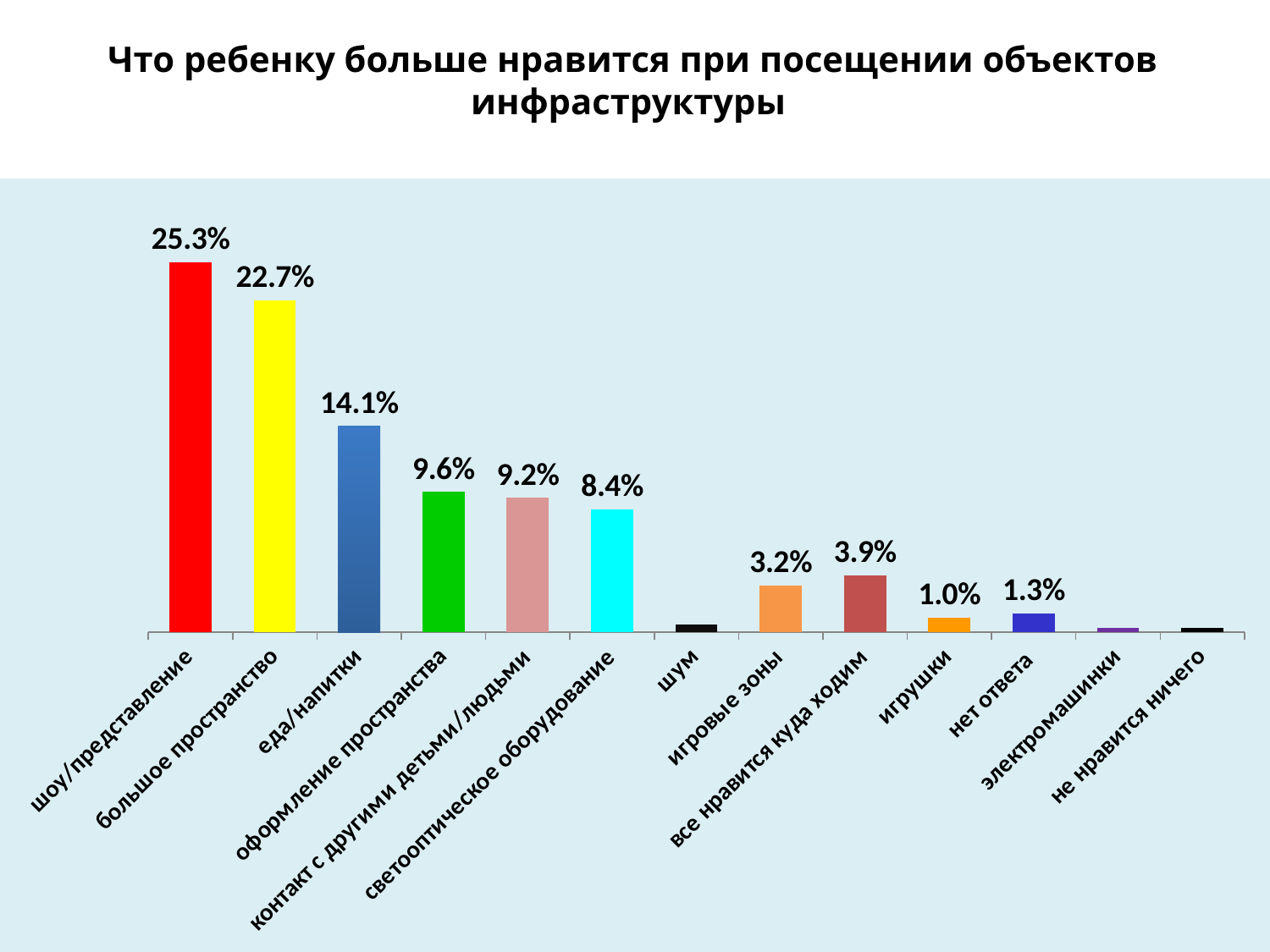
What is the value for большое пространство? 22.7% What is the value for еда/напитки? 14.1% How many categories are shown on the x axis? 13 What is the value for игрушки? 1.0% What is the value for шоу/представление? 25.3% Which is larger, the value for игровые зоны or the value for все нравится куда ходим? все нравится куда ходим What type of chart is shown on the slide? bar chart What is the value for светооптическое оборудование? 8.4% What is the title of the chart? Что ребенку больше нравится при посещении объектов инфраструктуры What is the difference between the values for шоу/представление and большое пространство? 2.6% What is the difference between the values for оформление пространства and контакт с другими детьми/людьми? 0.4% Which category has the highest value? шоу/представление